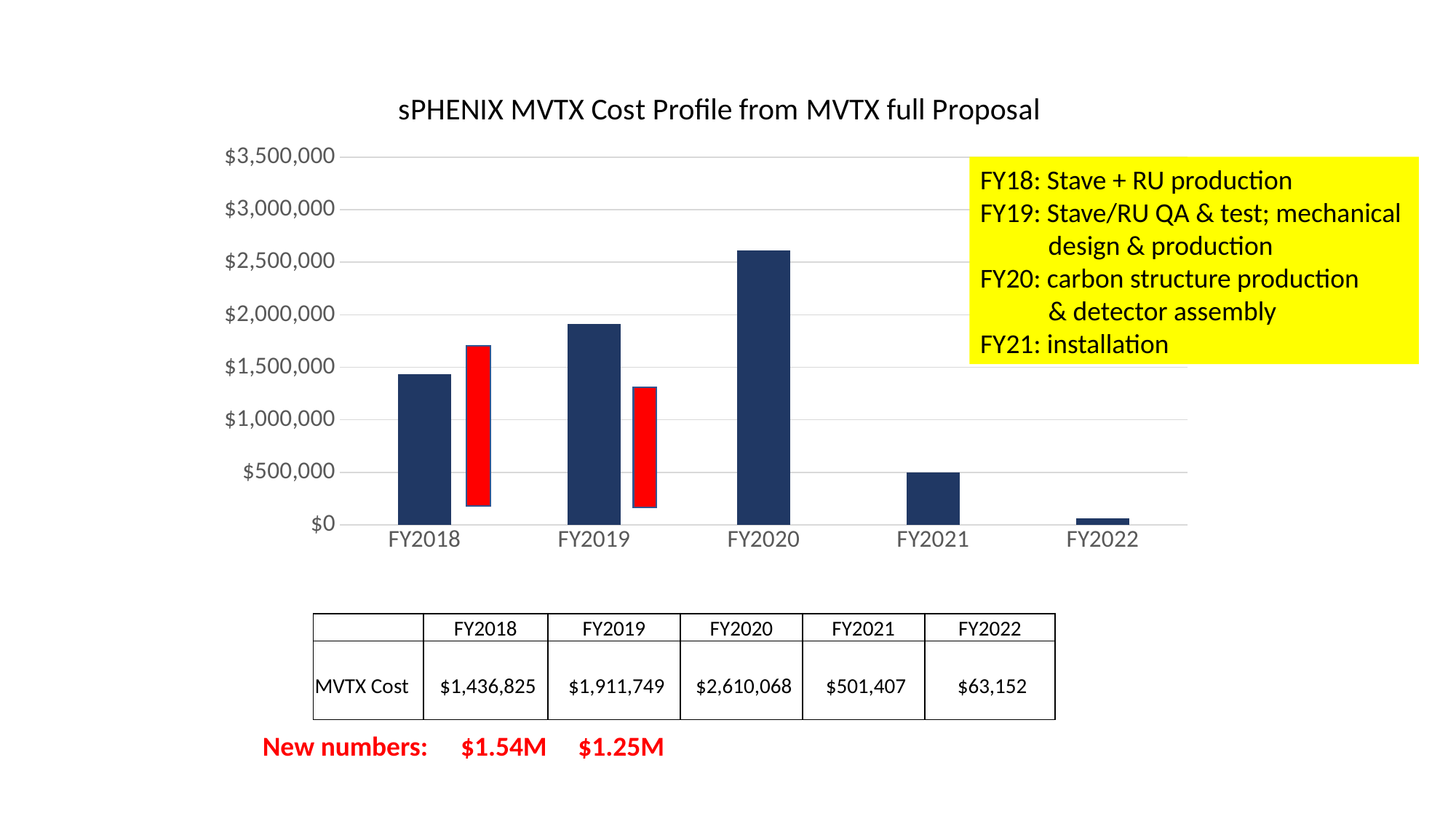
What is the difference between the MVTX Cost for FY2019 and FY2018? $474,924 What colour are the additional bars shown next to the FY2018 and FY2019 bars? red How many fiscal years are shown on the x axis of the chart? 5 What is the MVTX Cost for FY2020? $2,610,068 Which has the larger MVTX Cost, FY2018 or FY2019? FY2019 What is the MVTX Cost for FY2021? $501,407 Is the MVTX Cost bar for FY2021 greater or less than $1,000,000? less Which fiscal year has the highest MVTX Cost? FY2020 What kind of chart is shown on the slide? bar chart What is the MVTX Cost for FY2022? $63,152 Which fiscal year has the lowest MVTX Cost? FY2022 What is the title of the chart? sPHENIX MVTX Cost Profile from MVTX full Proposal